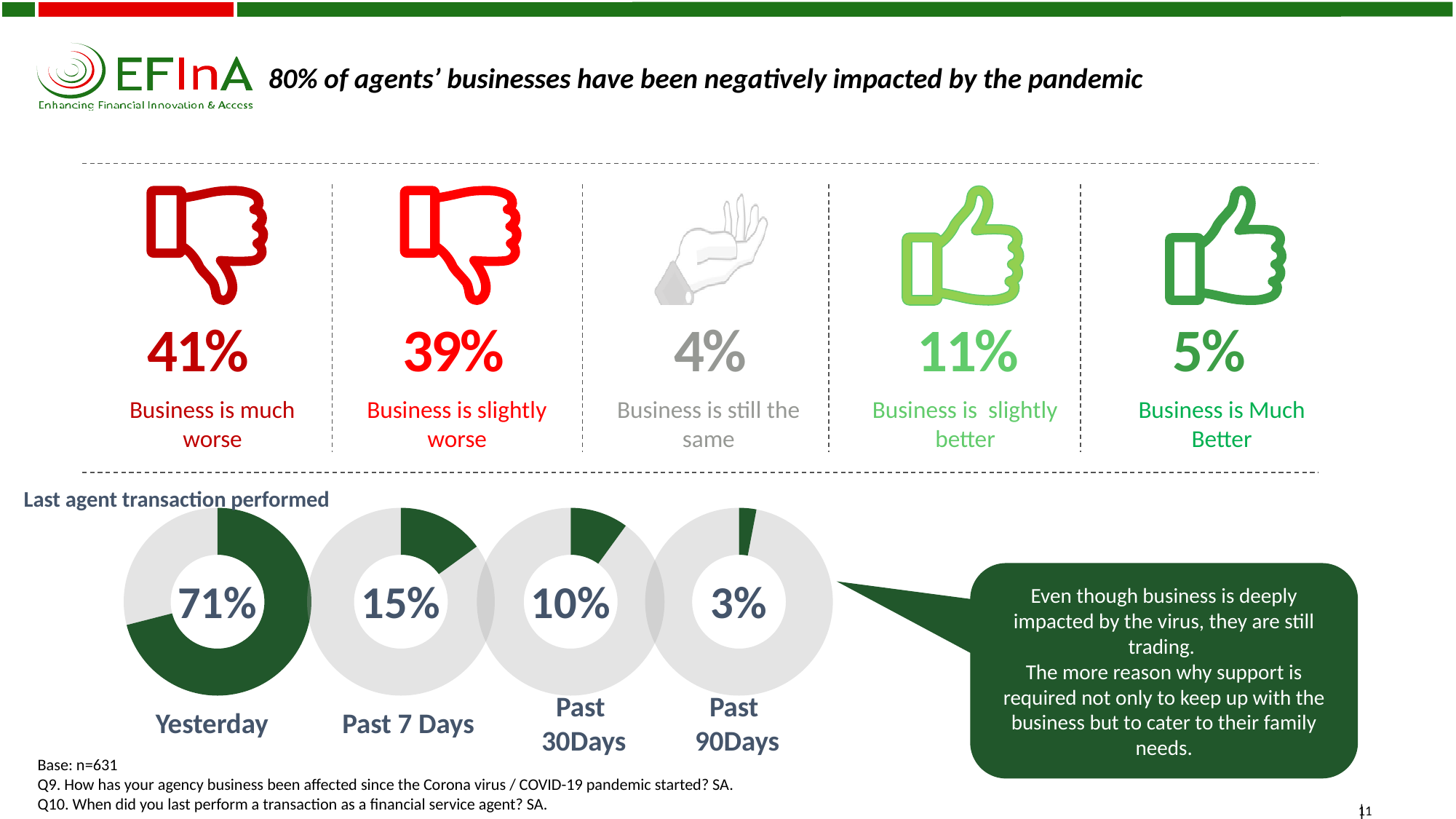
In the 'Last agent transaction performed' section, what is the difference between the Yesterday and Past 7 Days values? 56% In the business impact infographic at the top, which is larger: 'Business is slightly better' or 'Business is Much Better'? Business is slightly better In the 'Last agent transaction performed' section, which time period has the lowest share? Past 90Days In the 'Last agent transaction performed' donut charts, what is the value for Past 7 Days? 15% In the business impact infographic at the top, what percentage of agents said business is much worse? 41% In the business impact infographic at the top, what percentage of agents said business is still the same? 4% In the 'Last agent transaction performed' section, how many donut charts are shown? 4 In the 'Last agent transaction performed' donut charts, what is the value for Past 90Days? 3% What kind of chart is used in the 'Last agent transaction performed' section? Donut chart In the business impact infographic at the top, what is the combined total of 'Business is much worse' and 'Business is slightly worse'? 80% In the 'Last agent transaction performed' donut charts, what percentage of agents performed their last transaction yesterday? 71% In the 'Last agent transaction performed' section, which time period has the highest share? Yesterday